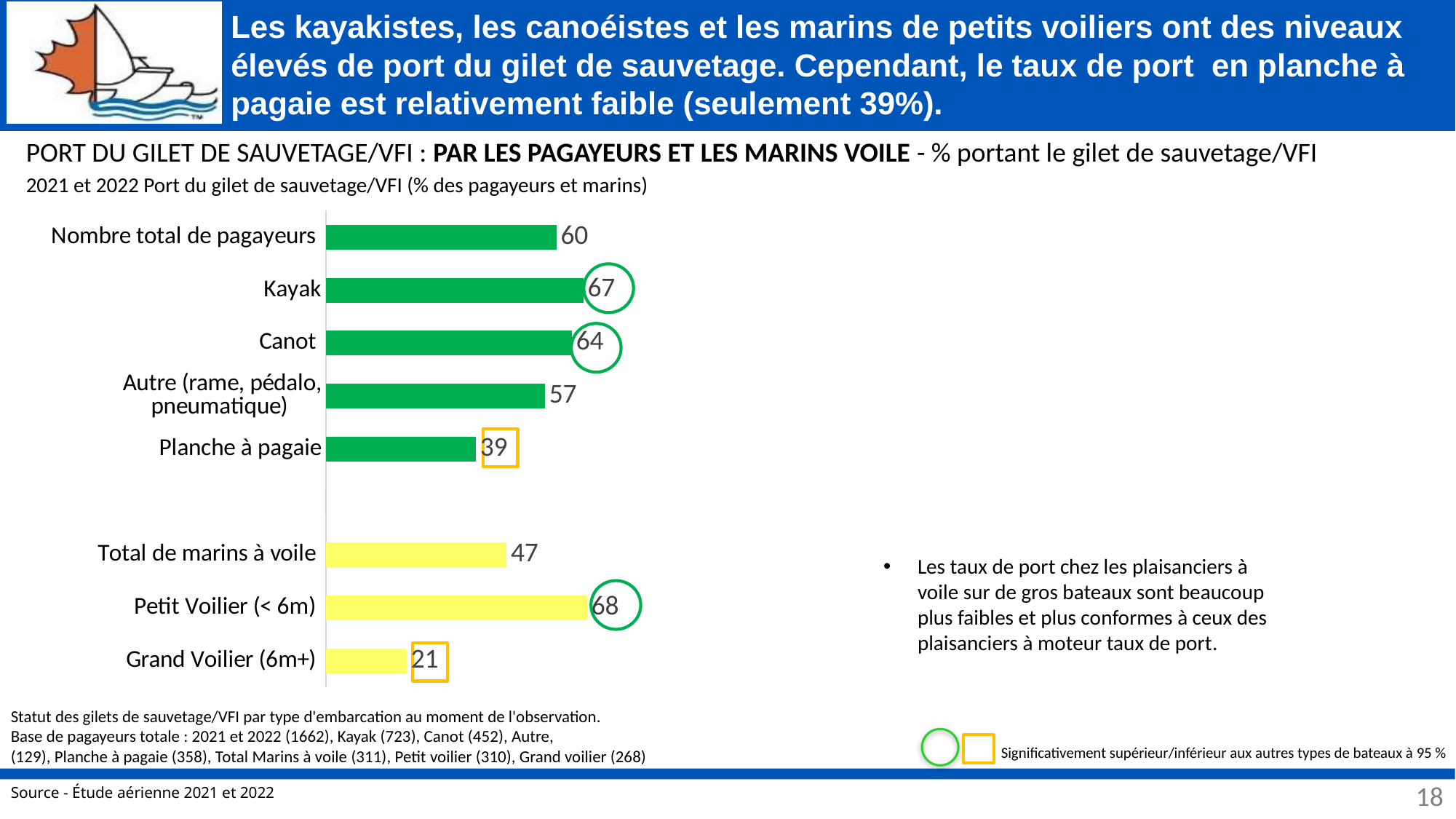
What is the value for Kayak? 67 Which category has the lowest value? Grand Voilier (6m+) Which category has the highest value? Petit Voilier (< 6m) What is the value for Total de marins à voile? 47 What is the difference between the values for Kayak and Canot? 3 What is the difference between the values for Petit Voilier (< 6m) and Grand Voilier (6m+)? 47 What is the value for Planche à pagaie? 39 Which is larger, the value for Nombre total de pagayeurs or the value for Total de marins à voile? Nombre total de pagayeurs What colour are the bars for the sailing (marins à voile) categories? Yellow What is the value for Grand Voilier (6m+)? 21 How many categories are plotted in the chart? 8 What kind of chart is shown on the slide? Bar chart